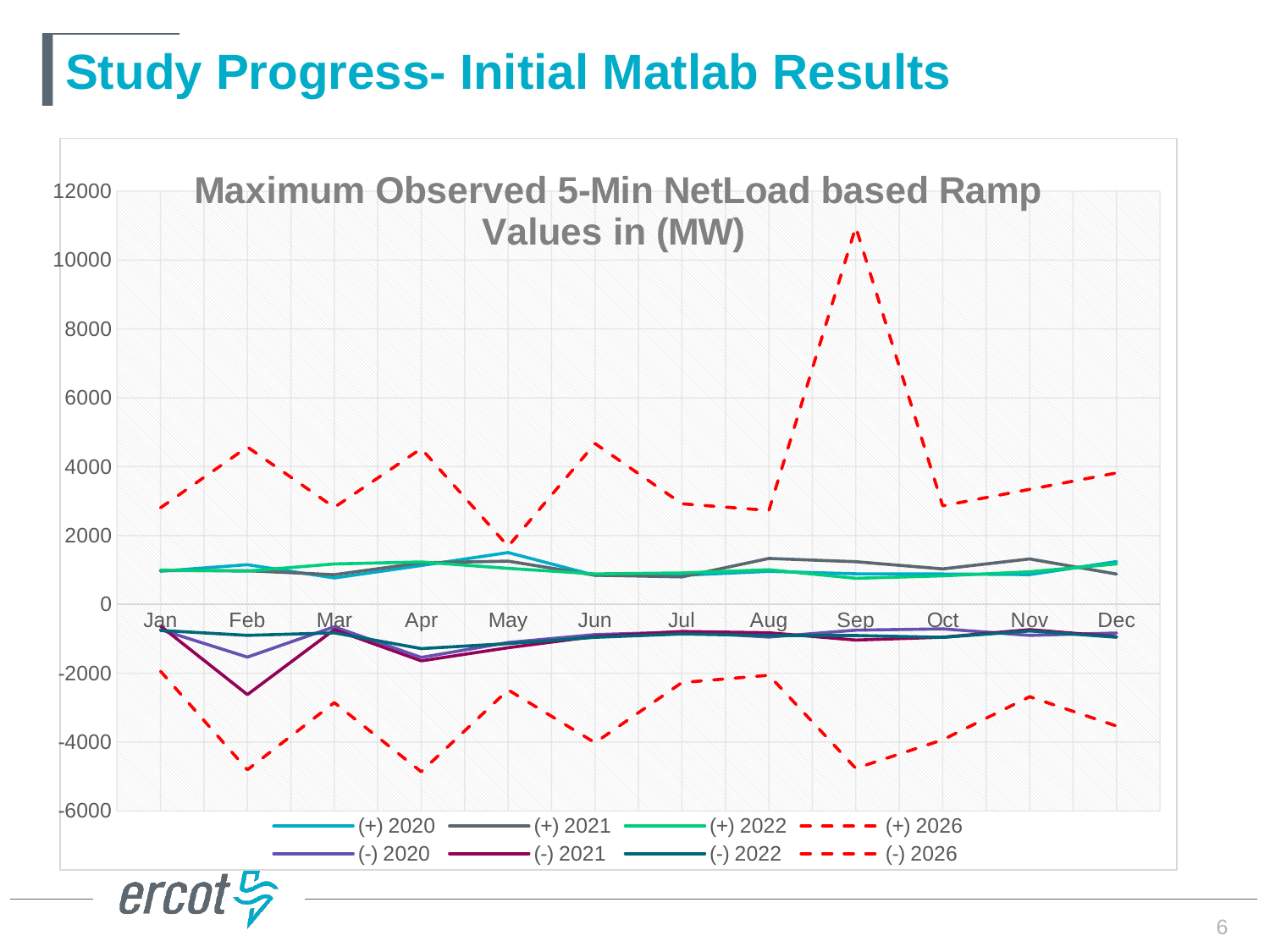
Is the value for (-) 2021 in Feb greater or less than -2000? less Is the value for (-) 2026 in Feb greater or less than -4000? less Which year's series are drawn with red dashed lines? 2026 Does the (+) 2026 series rise or fall from Sep to Oct? fall How many months are plotted along the x axis? 12 In which month does the (+) 2026 series reach its highest value? Sep What kind of chart is shown on the slide? line chart Which is larger for the (+) 2026 series, the value in Jun or the value in Jul? Jun What is the title of the chart? Maximum Observed 5-Min NetLoad based Ramp Values in (MW) Is the value for (+) 2026 in Oct greater or less than 4000? less How many series does the legend list? 8